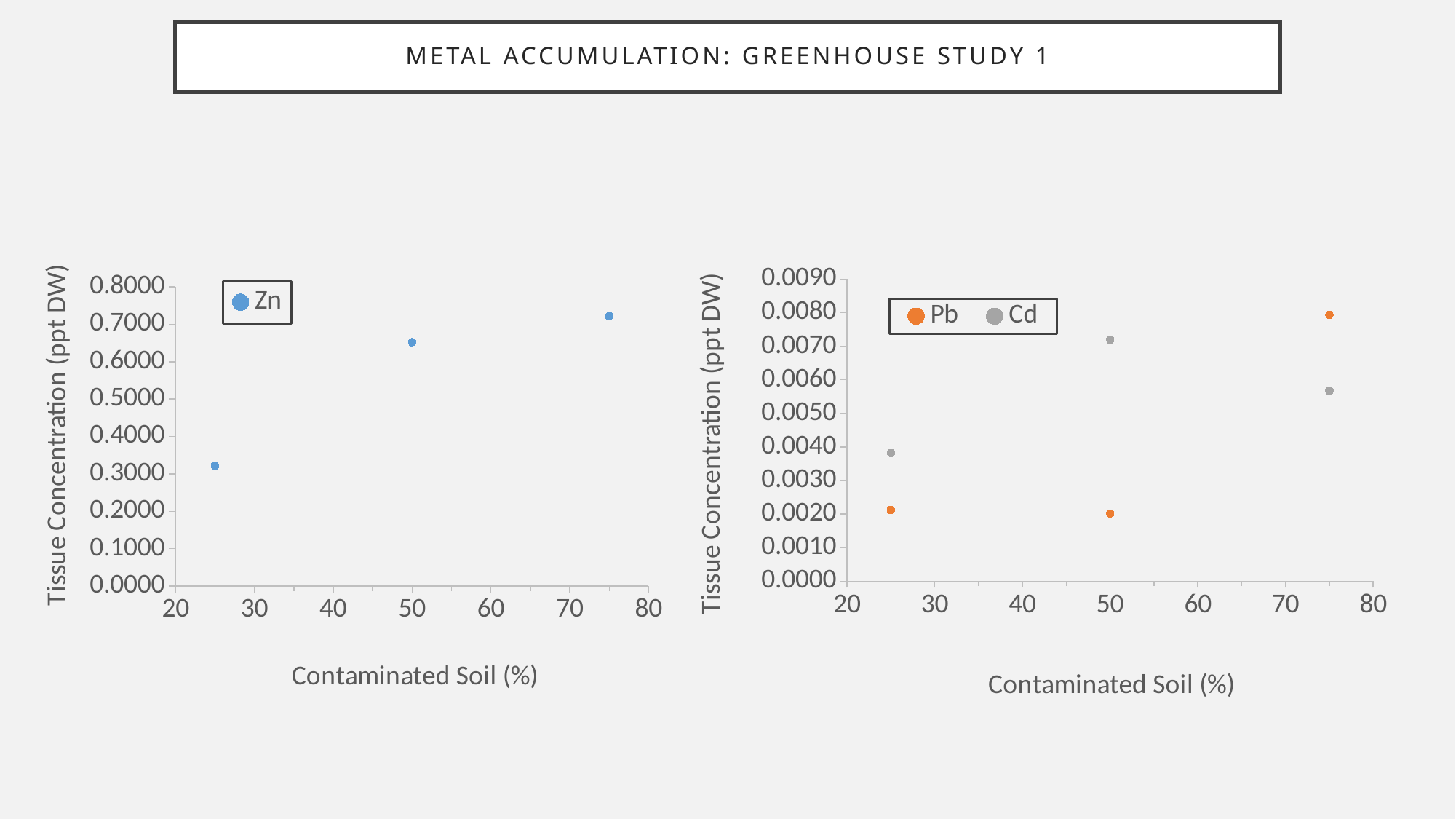
On the left chart, at which contaminated soil percentage is the Zn tissue concentration lowest? 25 On the left chart, how many Zn data points are plotted? 3 On the right chart, how many series does the legend list? 2 On the left chart, does the Zn tissue concentration rise or fall as contaminated soil percentage increases? rise On the right chart, at 25% contaminated soil, which has the higher tissue concentration, Pb or Cd? Cd On the left chart, is the Zn tissue concentration at 75% contaminated soil greater or less than 0.7000? greater On the right chart, which series are listed in the legend? Pb and Cd On the right chart, at 75% contaminated soil, which has the higher tissue concentration, Pb or Cd? Pb What kind of chart is the left chart (Zn)? scatter chart On the left chart, is the Zn tissue concentration at 25% contaminated soil greater or less than 0.4000? less On the right chart, is the Cd tissue concentration at 50% contaminated soil greater or less than 0.0060? greater